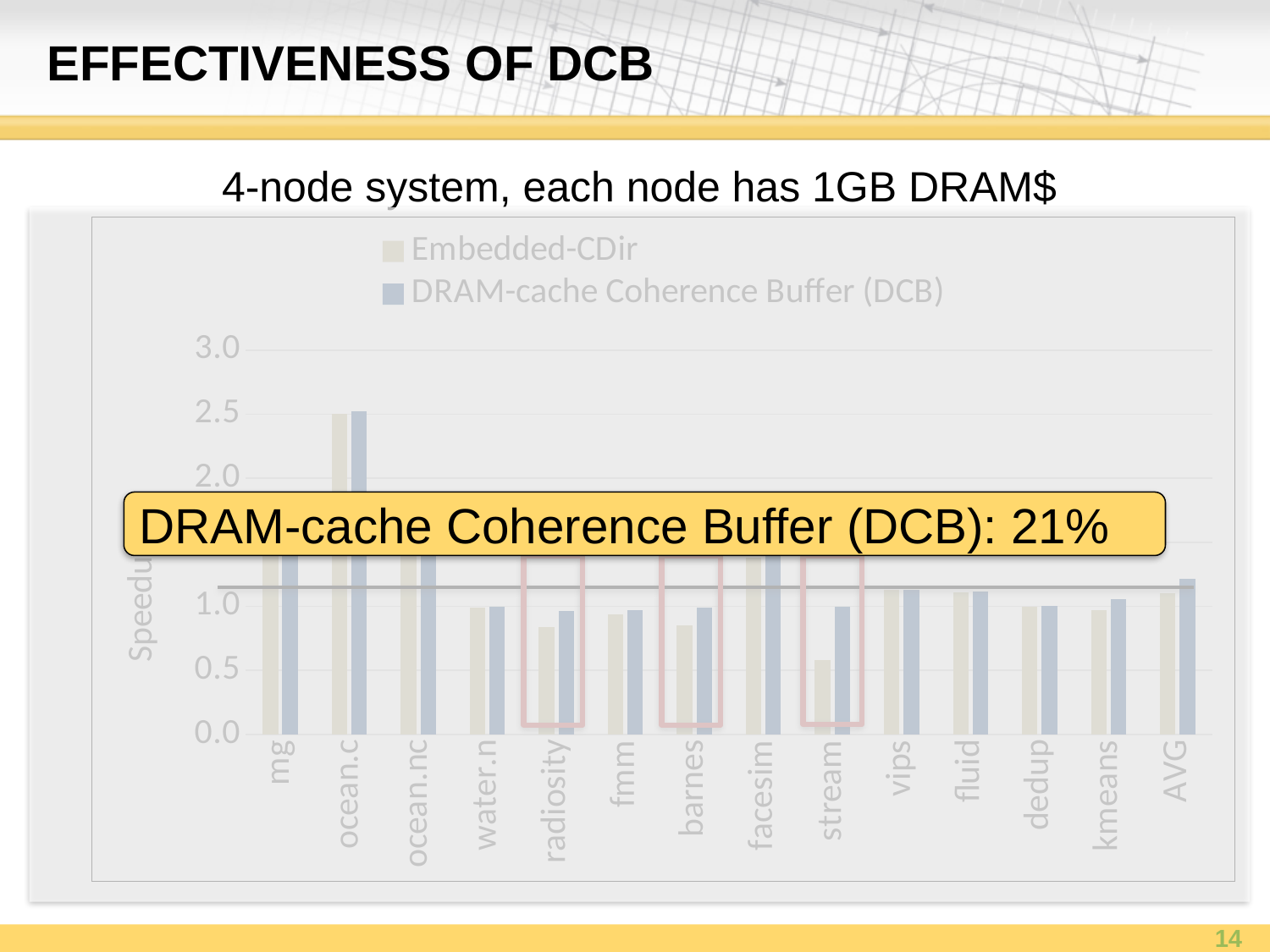
How many categories are shown along the x axis of the chart? 14 Which category has the lowest Embedded-CDir speedup? stream What is the label of the y axis of the chart? Speedup Is the Embedded-CDir value for stream greater or less than 1.0? less How many series does the chart legend list? 2 What kind of chart is shown on the slide? bar chart Is the DRAM-cache Coherence Buffer (DCB) value for ocean.c greater or less than 2.0? greater Which category has the highest DRAM-cache Coherence Buffer (DCB) speedup? ocean.c Is the Embedded-CDir value for radiosity greater or less than 1.0? less For stream, which series has the larger value: Embedded-CDir or DRAM-cache Coherence Buffer (DCB)? DRAM-cache Coherence Buffer (DCB) Which has the larger DRAM-cache Coherence Buffer (DCB) value: ocean.c or water.n? ocean.c What are the two series named in the chart legend? Embedded-CDir and DRAM-cache Coherence Buffer (DCB)